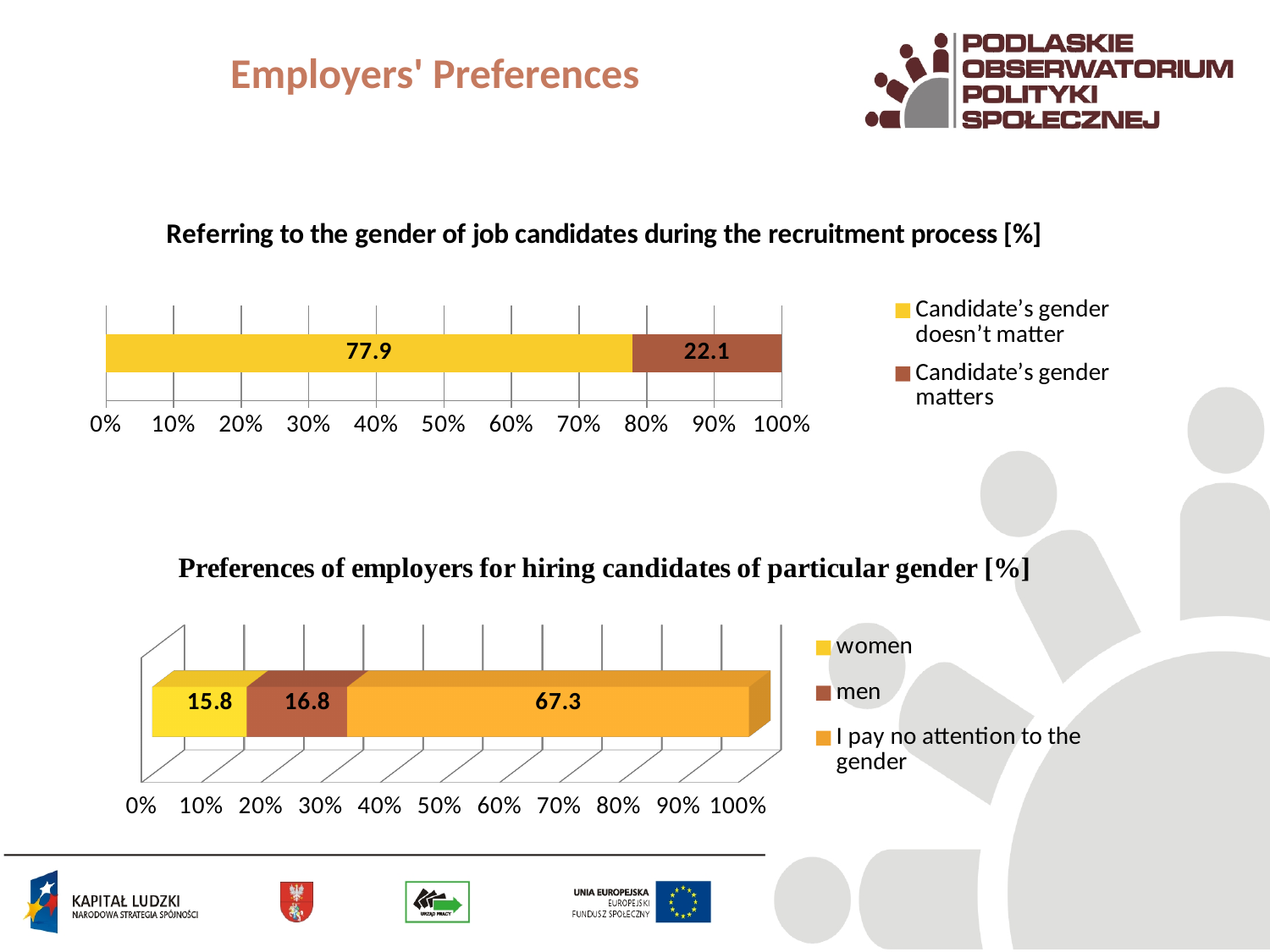
How many series does the legend of the bottom chart 'Preferences of employers for hiring candidates of particular gender [%]' list? 3 In the top chart 'Referring to the gender of job candidates during the recruitment process [%]', what is the value for 'Candidate's gender matters'? 22.1 In the bottom chart 'Preferences of employers for hiring candidates of particular gender [%]', which series has the highest value? I pay no attention to the gender In the top chart 'Referring to the gender of job candidates during the recruitment process [%]', what is the difference between the two values? 55.8 How many series does the legend of the top chart 'Referring to the gender of job candidates during the recruitment process [%]' list? 2 What kind of chart is the bottom chart 'Preferences of employers for hiring candidates of particular gender [%]'? Stacked bar chart In the top chart 'Referring to the gender of job candidates during the recruitment process [%]', what is the value for 'Candidate's gender doesn't matter'? 77.9 In the bottom chart 'Preferences of employers for hiring candidates of particular gender [%]', what is the value for 'women'? 15.8 In the bottom chart 'Preferences of employers for hiring candidates of particular gender [%]', what is the value for 'men'? 16.8 In the bottom chart 'Preferences of employers for hiring candidates of particular gender [%]', what is the value for 'I pay no attention to the gender'? 67.3 In the bottom chart 'Preferences of employers for hiring candidates of particular gender [%]', what is the difference between the values for 'men' and 'women'? 1.0 In the top chart 'Referring to the gender of job candidates during the recruitment process [%]', which series has the larger value? Candidate's gender doesn't matter